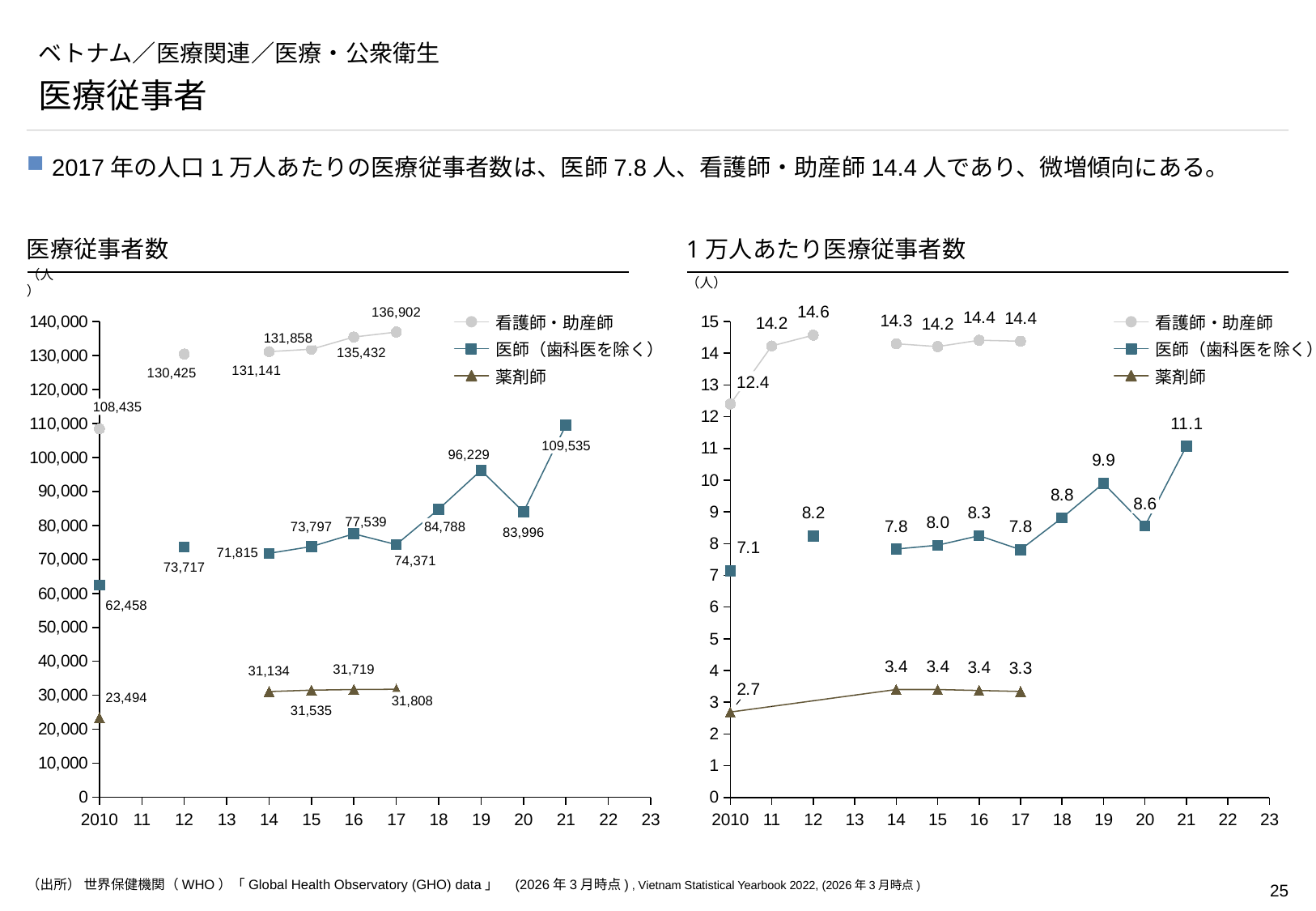
In the left chart (医療従事者数), in which year is the 医師（歯科医を除く） series at its lowest? 2010 In the right chart (1万人あたり医療従事者数), what is the value for 医師（歯科医を除く） in 2019? 9.9 In the right chart (1万人あたり医療従事者数), what is the value for 看護師・助産師 in 2012? 14.6 In the left chart (医療従事者数), how many series does the legend list? 3 In the left chart (医療従事者数), what is the difference between the 医師（歯科医を除く） values for 2019 and 2020? 12,233 In the left chart (医療従事者数), what is the value for 看護師・助産師 in 2017? 136,902 What kind of chart is the right chart (1万人あたり医療従事者数)? line chart In the right chart (1万人あたり医療従事者数), what is the difference between the 医師（歯科医を除く） values for 2021 and 2010? 4.0 In the right chart (1万人あたり医療従事者数), which is larger: the 薬剤師 value in 2014 or in 2017? 2014 In the right chart (1万人あたり医療従事者数), in which year is the 医師（歯科医を除く） series at its highest? 2021 In the left chart (医療従事者数), what is the value for 薬剤師 in 2010? 23,494 In the left chart (医療従事者数), what is the value for 医師（歯科医を除く） in 2021? 109,535